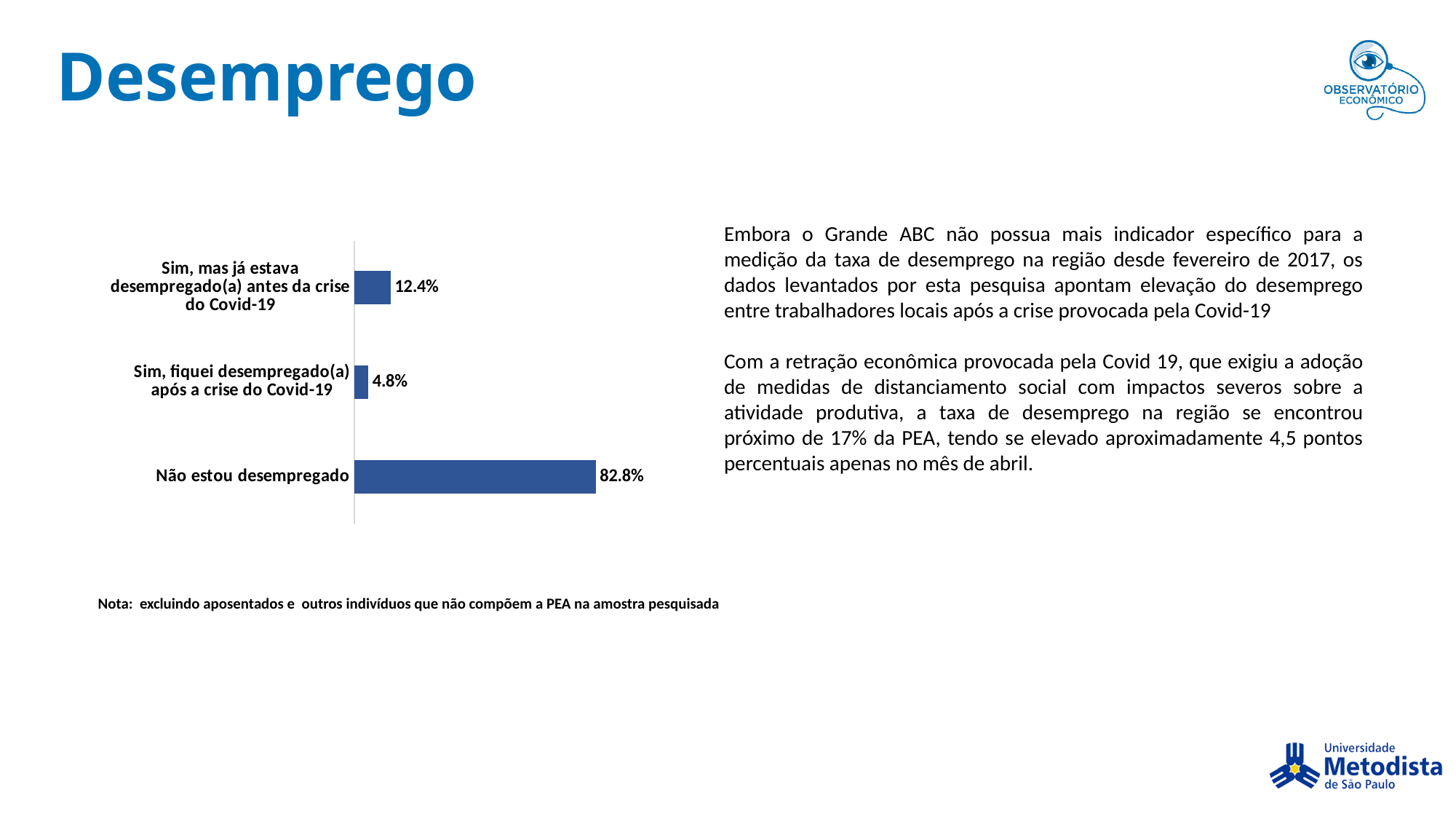
What is the difference between the values for "Não estou desempregado" and "Sim, mas já estava desempregado(a) antes da crise do Covid-19"? 70.4% Which category has the lowest value? Sim, fiquei desempregado(a) após a crise do Covid-19 Which is larger: the value for "Sim, mas já estava desempregado(a) antes da crise do Covid-19" or for "Sim, fiquei desempregado(a) após a crise do Covid-19"? Sim, mas já estava desempregado(a) antes da crise do Covid-19 What is the value for "Sim, fiquei desempregado(a) após a crise do Covid-19"? 4.8% Which category has the highest value? Não estou desempregado What is the difference between the values for "Sim, mas já estava desempregado(a) antes da crise do Covid-19" and "Sim, fiquei desempregado(a) após a crise do Covid-19"? 7.6% What colour are the bars in the chart? Blue What kind of chart is shown on the slide? Bar chart How many categories are shown in the chart? 3 What is the value for "Sim, mas já estava desempregado(a) antes da crise do Covid-19"? 12.4% What is the value for "Não estou desempregado"? 82.8% What is the title of the slide containing the chart? Desemprego